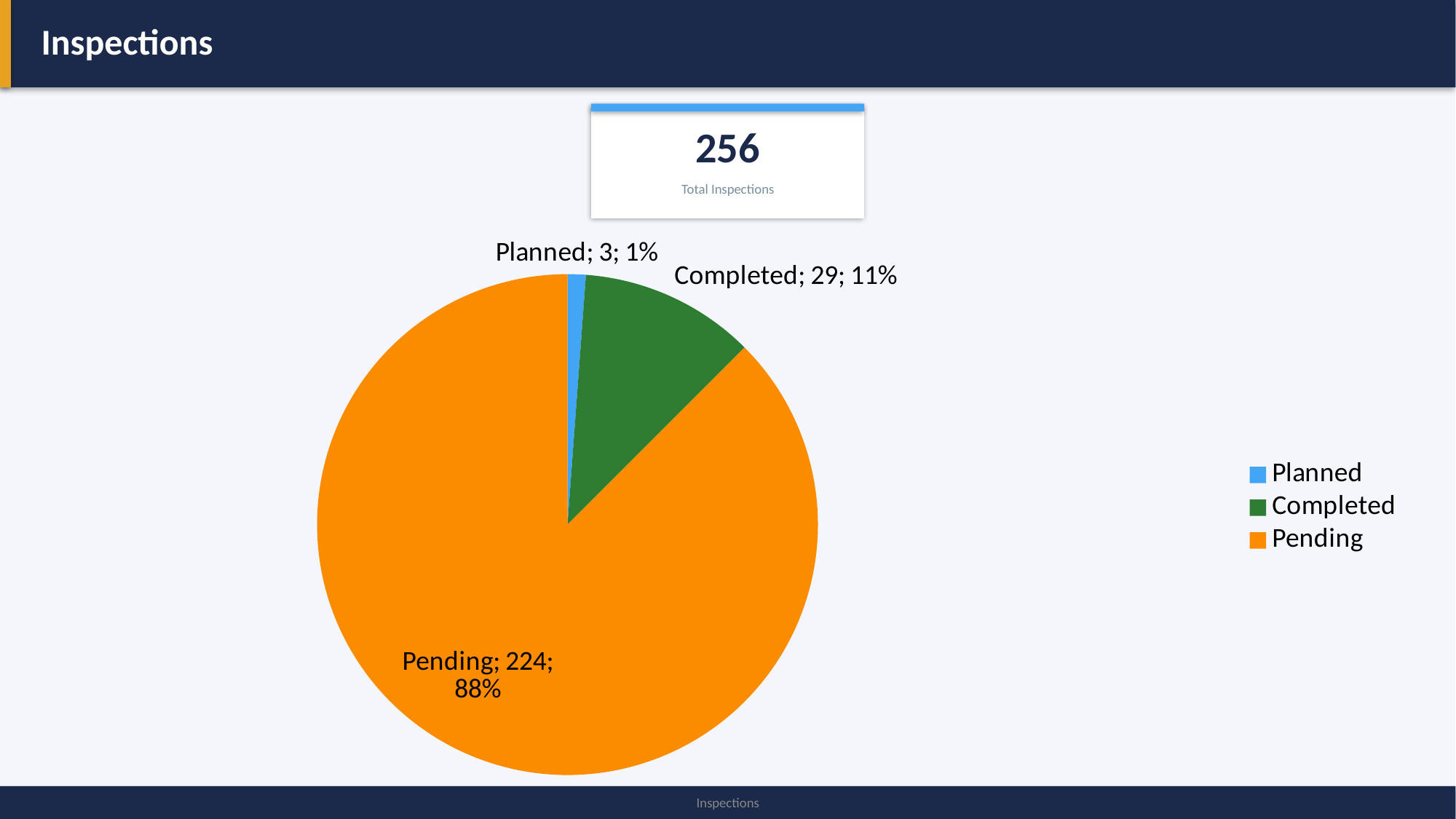
How many inspections are Completed? 29 What kind of chart is shown on the slide? pie chart How many inspections are Pending? 224 What share of the pie does the Completed slice represent? 11% Which category has the smallest slice? Planned What is the difference between the Pending and Completed counts? 195 How many categories does the pie chart have? 3 How many inspections are Planned? 3 Which is larger, Completed or Planned? Completed What share of the pie does the Pending slice represent? 88% Which category has the largest slice? Pending What colour is the Pending slice? orange